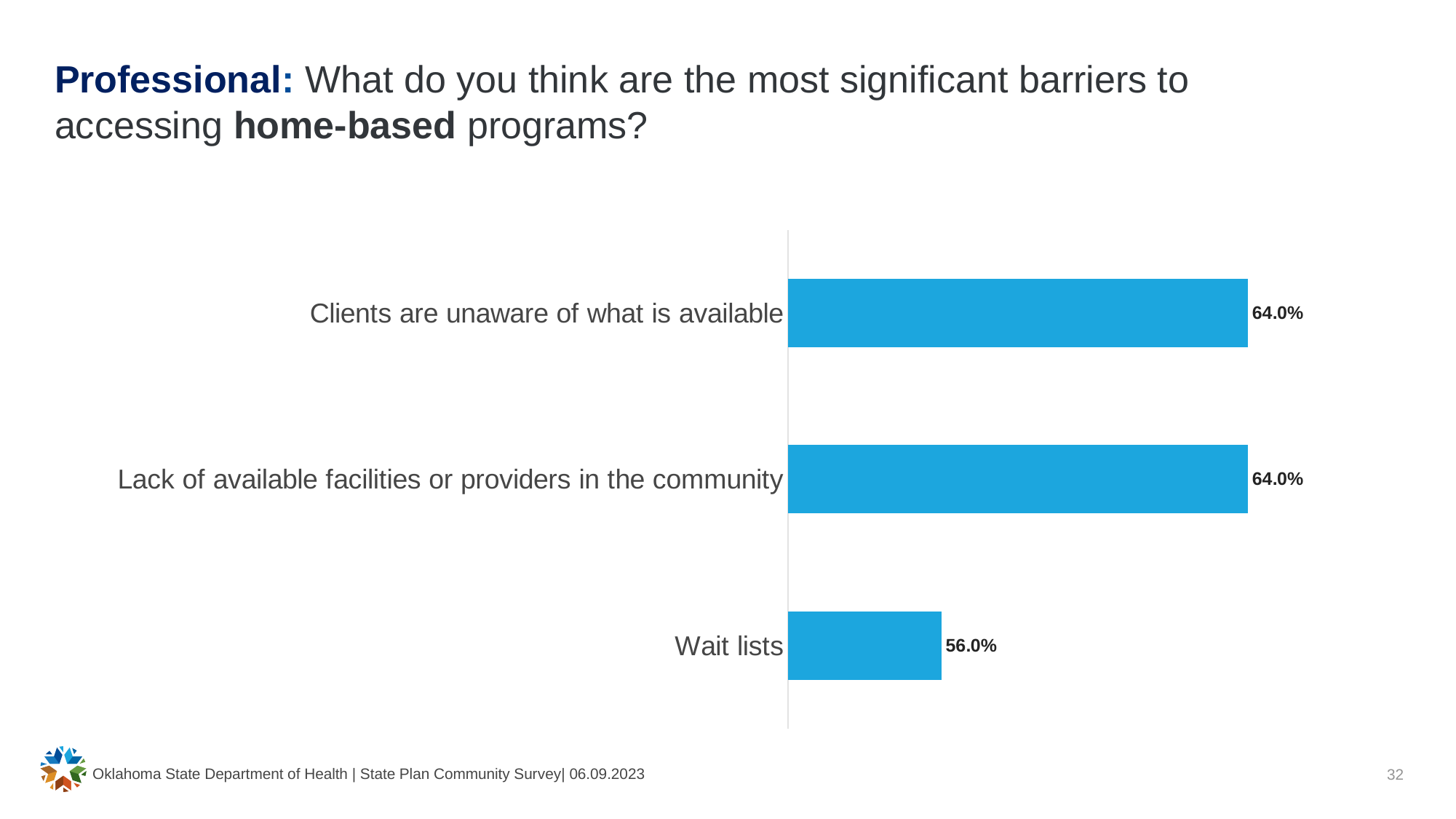
Do "Clients are unaware of what is available" and "Lack of available facilities or providers in the community" have the same value? Yes What colour are the bars in the chart? Blue What is the difference between the value for "Clients are unaware of what is available" and the value for "Wait lists"? 8.0% What percentage is shown for "Clients are unaware of what is available"? 64.0% Which is larger: the value for "Lack of available facilities or providers in the community" or the value for "Wait lists"? Lack of available facilities or providers in the community Which barrier has the lowest percentage? Wait lists Which type of programs does the slide's question ask about barriers to accessing? Home-based programs What percentage is shown for "Lack of available facilities or providers in the community"? 64.0% What kind of chart is shown on the slide? Bar chart How many barriers are plotted in the chart? 3 What percentage is shown for "Wait lists"? 56.0%